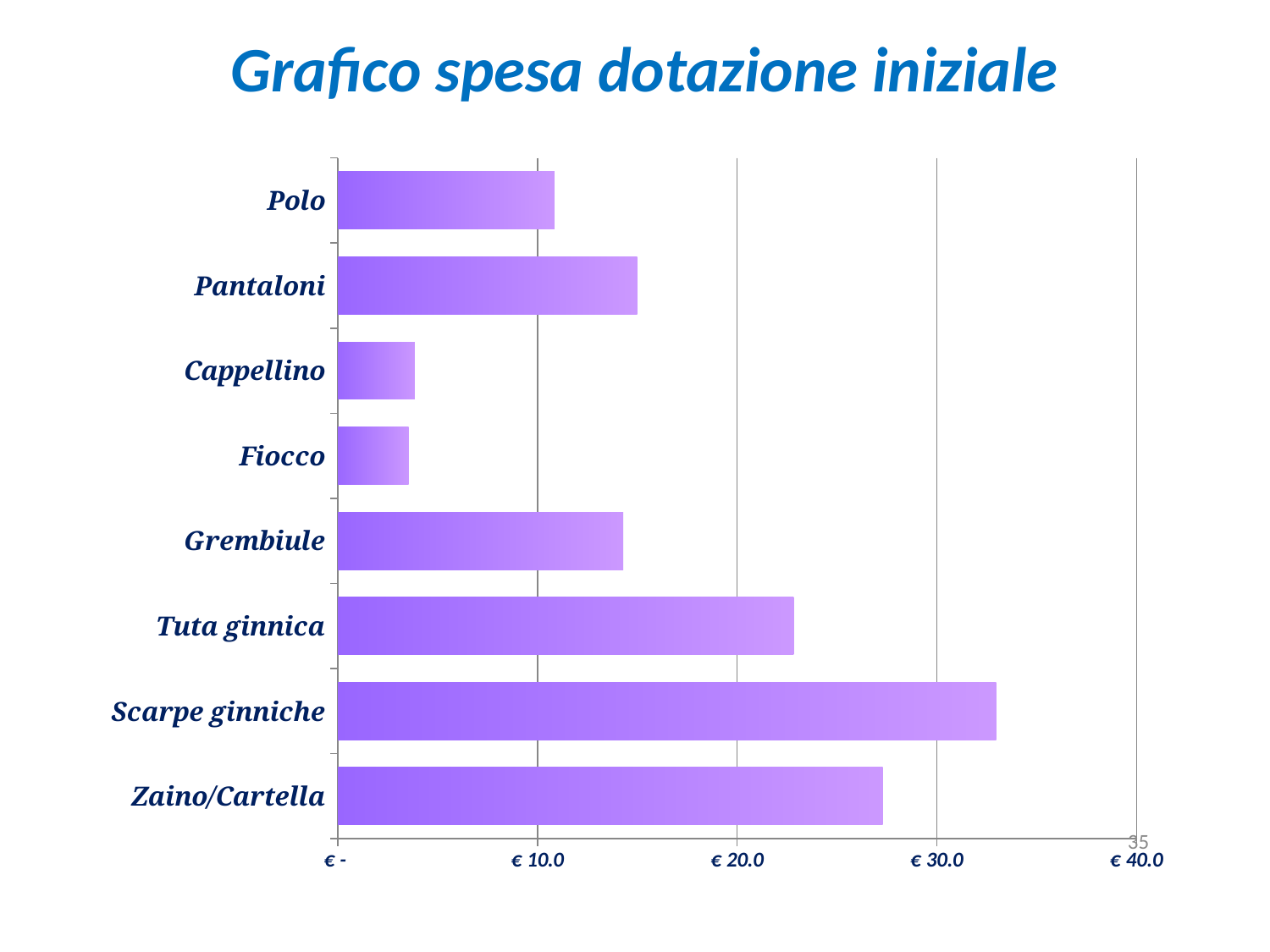
How many categories are plotted in the chart? 8 What kind of chart is shown on the slide? bar chart Is the value for Scarpe ginniche greater or less than € 30.0? greater Is the value for Zaino/Cartella greater or less than € 30.0? less Which is larger, the value for Tuta ginnica or the value for Grembiule? Tuta ginnica Is the value for Tuta ginnica greater or less than € 20.0? greater Which is larger, the value for Pantaloni or the value for Polo? Pantaloni Which category has the highest value? Scarpe ginniche Which is larger, the value for Scarpe ginniche or the value for Zaino/Cartella? Scarpe ginniche What is the title of the chart? Grafico spesa dotazione iniziale